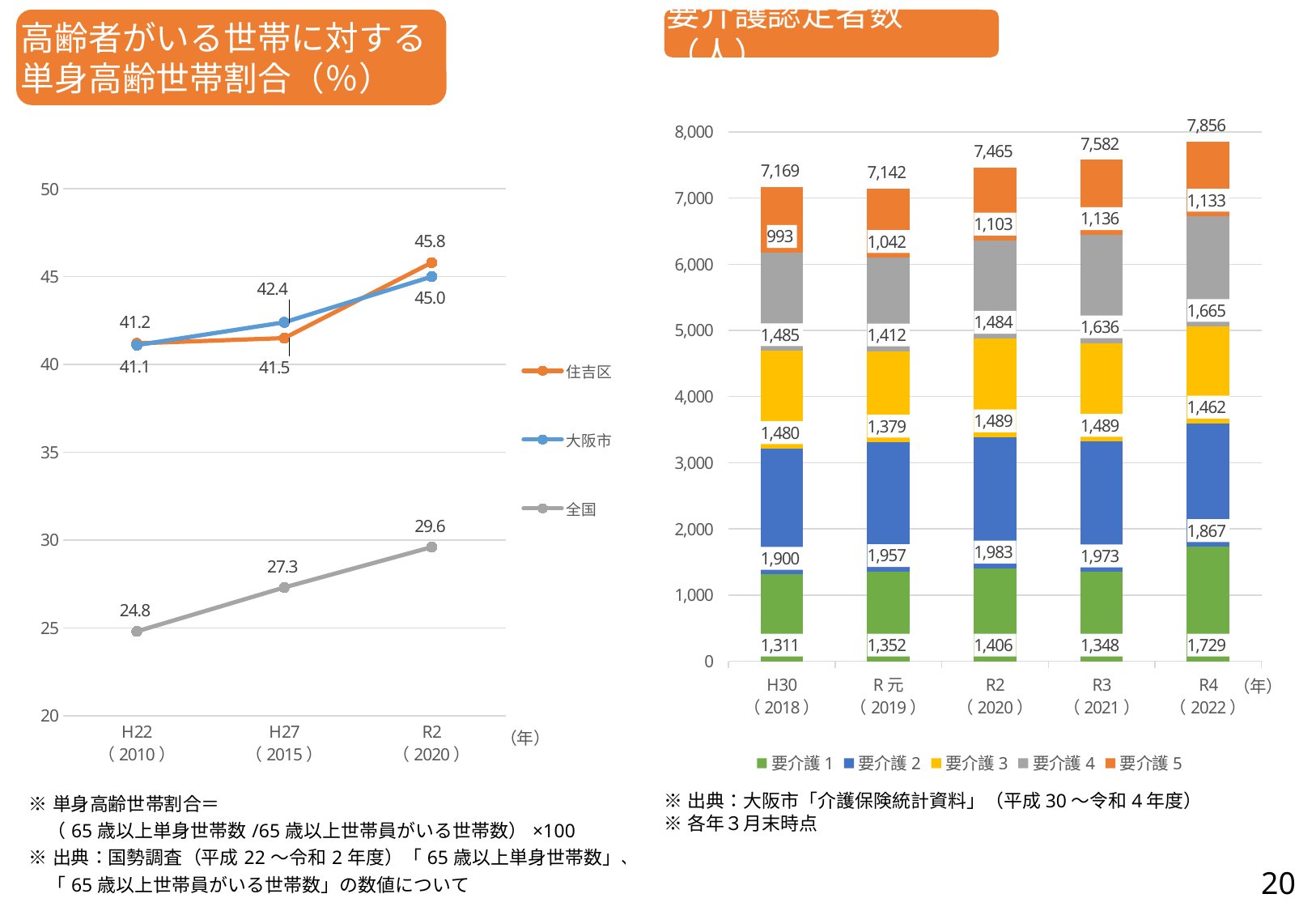
In the right chart (要介護認定者数), how many years are shown on the x axis? 5 In the left chart (高齢者がいる世帯に対する単身高齢世帯割合), what is the difference between 住吉区 and 全国 in R2 (2020)? 16.2 In the right chart (要介護認定者数), which year has the lowest total? R元 (2019) In the left chart (高齢者がいる世帯に対する単身高齢世帯割合), how many series does the legend list? 3 In the right chart (要介護認定者数), what is the total for R4 (2022)? 7,856 In the left chart (高齢者がいる世帯に対する単身高齢世帯割合), what kind of chart is it? line chart In the right chart (要介護認定者数), what is the value for 要介護 3 in R元 (2019)? 1,379 In the right chart (要介護認定者数), which is larger in R3 (2021): 要介護 1 or 要介護 4? 要介護 4 In the left chart (高齢者がいる世帯に対する単身高齢世帯割合), what is the value for 住吉区 in R2 (2020)? 45.8 In the left chart (高齢者がいる世帯に対する単身高齢世帯割合), does the 全国 line rise or fall from H22 (2010) to R2 (2020)? rise In the left chart (高齢者がいる世帯に対する単身高齢世帯割合), what is the value for 全国 in H27 (2015)? 27.3 In the right chart (要介護認定者数), what is the difference between 要介護 1 in R4 (2022) and 要介護 1 in R3 (2021)? 381